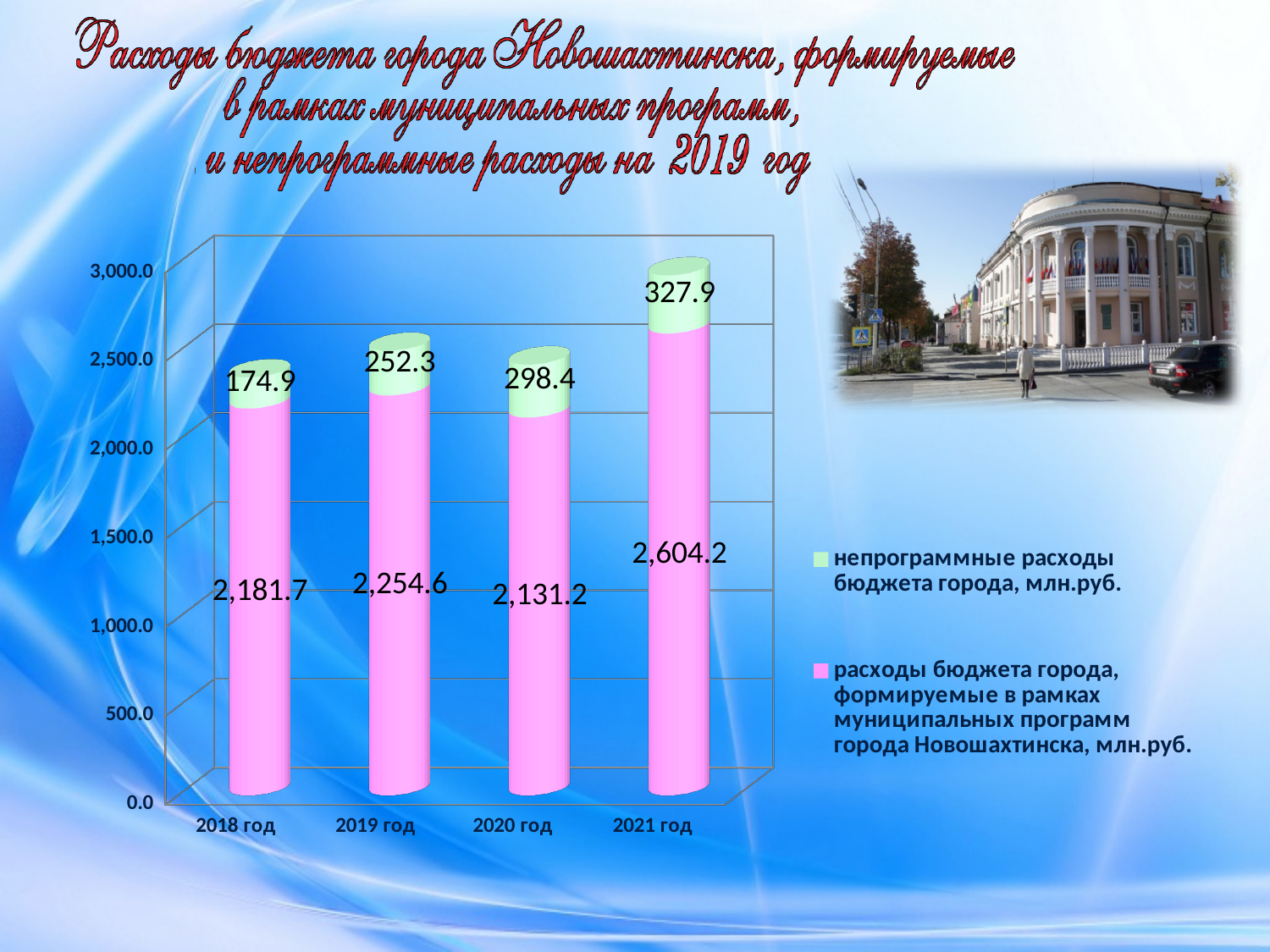
Which is larger: the программные расходы value for 2019 год or for 2020 год? 2019 год Which year has the lowest value for непрограммные расходы бюджета города? 2018 год What kind of chart is shown on the slide? Stacked bar chart How many years are shown on the x axis of the chart? 4 What is the value of расходы бюджета города, формируемые в рамках муниципальных программ for 2021 год? 2,604.2 How many series does the chart legend list? 2 What is the total of the stacked bar for 2018 год? 2,356.6 What is the total of the stacked bar for 2021 год? 2,932.1 What is the value of непрограммные расходы бюджета города for 2018 год? 174.9 Which year has the highest value for расходы бюджета города, формируемые в рамках муниципальных программ? 2021 год What is the value of непрограммные расходы бюджета города for 2020 год? 298.4 What is the difference between the непрограммные расходы values for 2021 год and 2019 год? 75.6